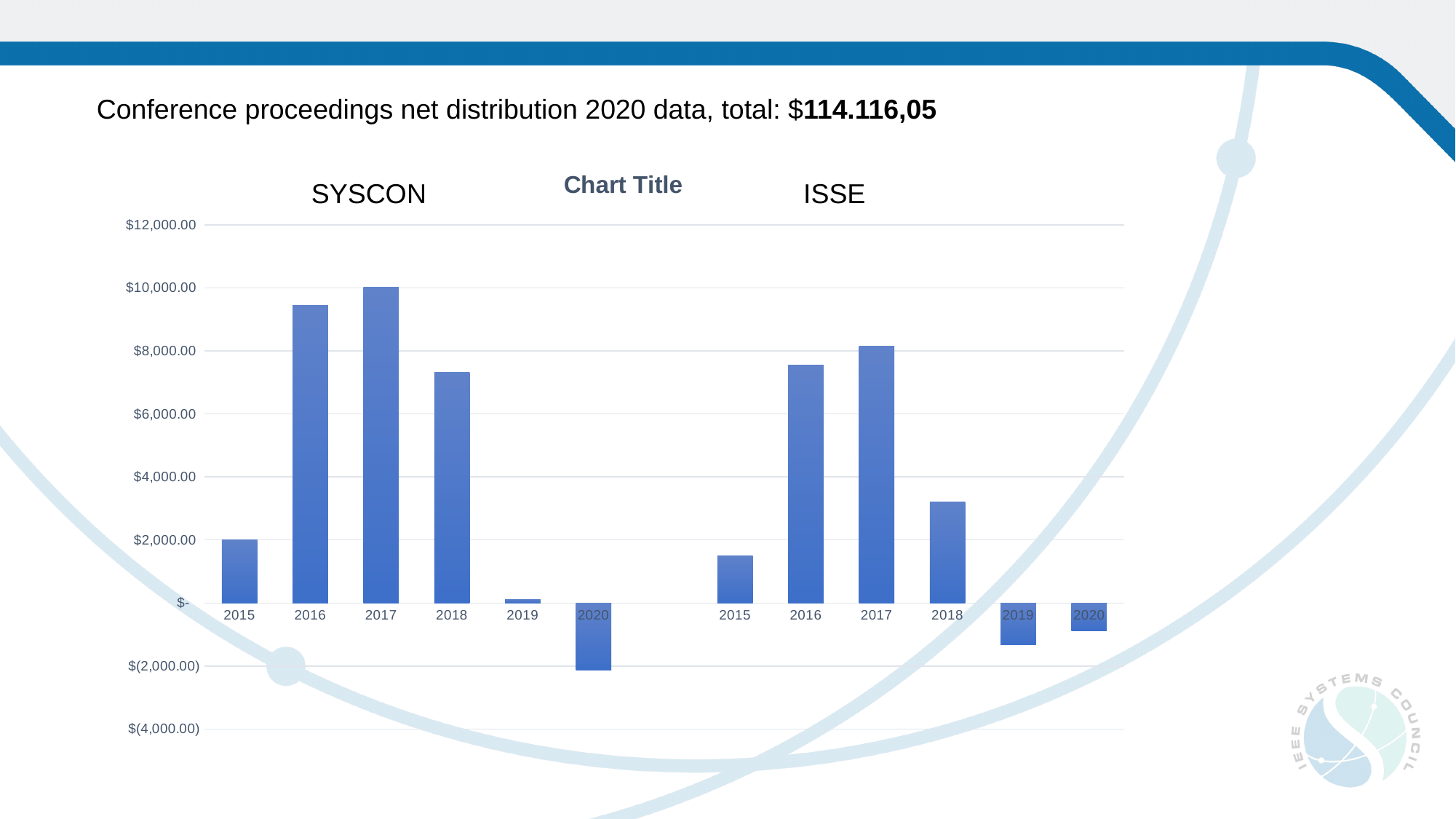
Which year has the lowest bar in the SYSCON group? 2020 How many years are shown for each of the SYSCON and ISSE groups? 6 Which year has the highest bar in the SYSCON group? 2017 Is the ISSE value for 2016 greater or less than $8,000.00? less What kind of chart is shown on the slide? bar chart Which is larger, the SYSCON value for 2018 or the ISSE value for 2018? SYSCON 2018 Which year has the highest bar in the ISSE group? 2017 Which year has the lowest bar in the ISSE group? 2019 Do the ISSE values rise or fall from 2017 to 2020? fall What is the total stated in the slide heading for the 2020 conference proceedings net distribution? $114.116,05